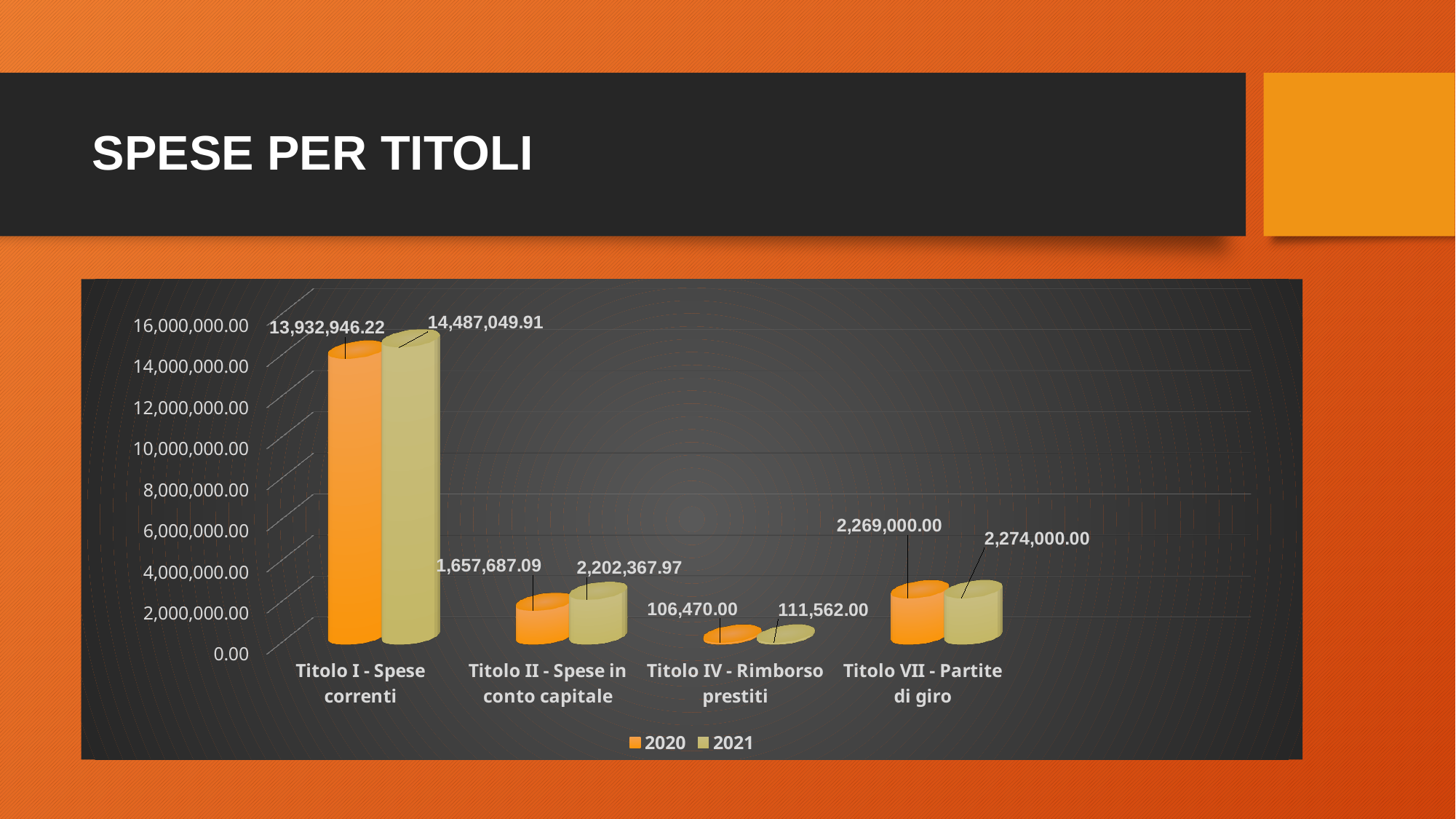
What is the 2021 value for Titolo II - Spese in conto capitale? 2,202,367.97 Which category has the lowest 2020 value? Titolo IV - Rimborso prestiti What is the 2021 value for Titolo VII - Partite di giro? 2,274,000.00 What is the 2020 value for Titolo I - Spese correnti? 13,932,946.22 What kind of chart is shown on the slide? Bar chart How many series does the legend list? 2 What is the difference between the 2021 and 2020 values for Titolo I - Spese correnti? 554,103.69 Which category has the highest 2021 value? Titolo I - Spese correnti Which is larger for Titolo II - Spese in conto capitale: the 2020 value or the 2021 value? 2021 How many categories are shown on the x axis? 4 What is the 2020 value for Titolo IV - Rimborso prestiti? 106,470.00 What is the difference between the 2021 and 2020 values for Titolo IV - Rimborso prestiti? 5,092.00